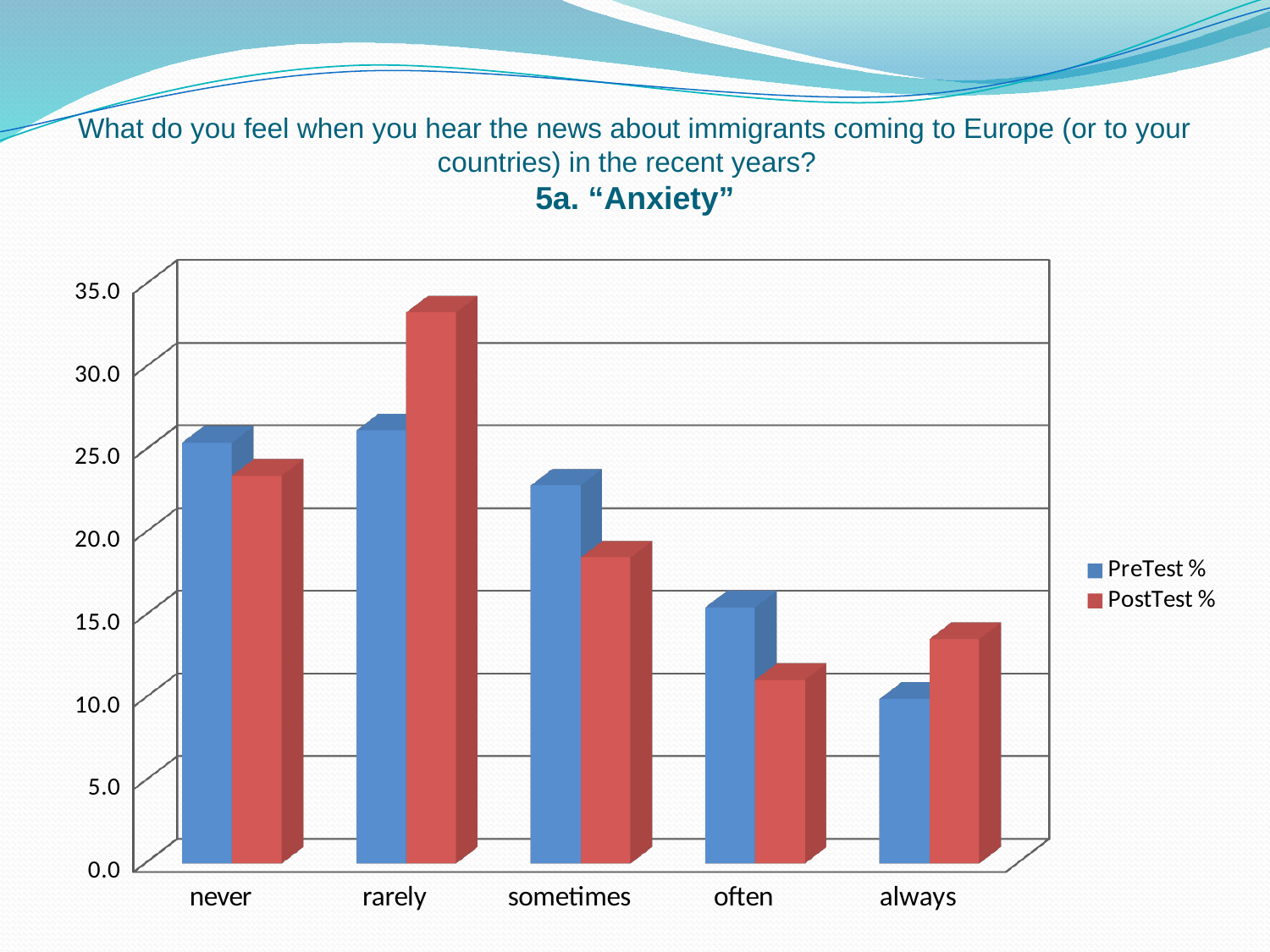
Is the PostTest % value for "rarely" greater or less than 30.0? greater For the category "rarely", which is larger: PreTest % or PostTest %? PostTest % For the category "always", which is larger: PreTest % or PostTest %? PostTest % Which category has the lowest PreTest % value? always Is the PreTest % value for "always" greater or less than 15.0? less Which category has the highest PostTest % value? rarely What are the two series names listed in the chart's legend? PreTest % and PostTest % How many categories are shown on the x axis of the chart? 5 Which category has the lowest PostTest % value? often How many series does the chart's legend list? 2 For the category "sometimes", which is larger: PreTest % or PostTest %? PreTest % What kind of chart is shown on the slide? bar chart